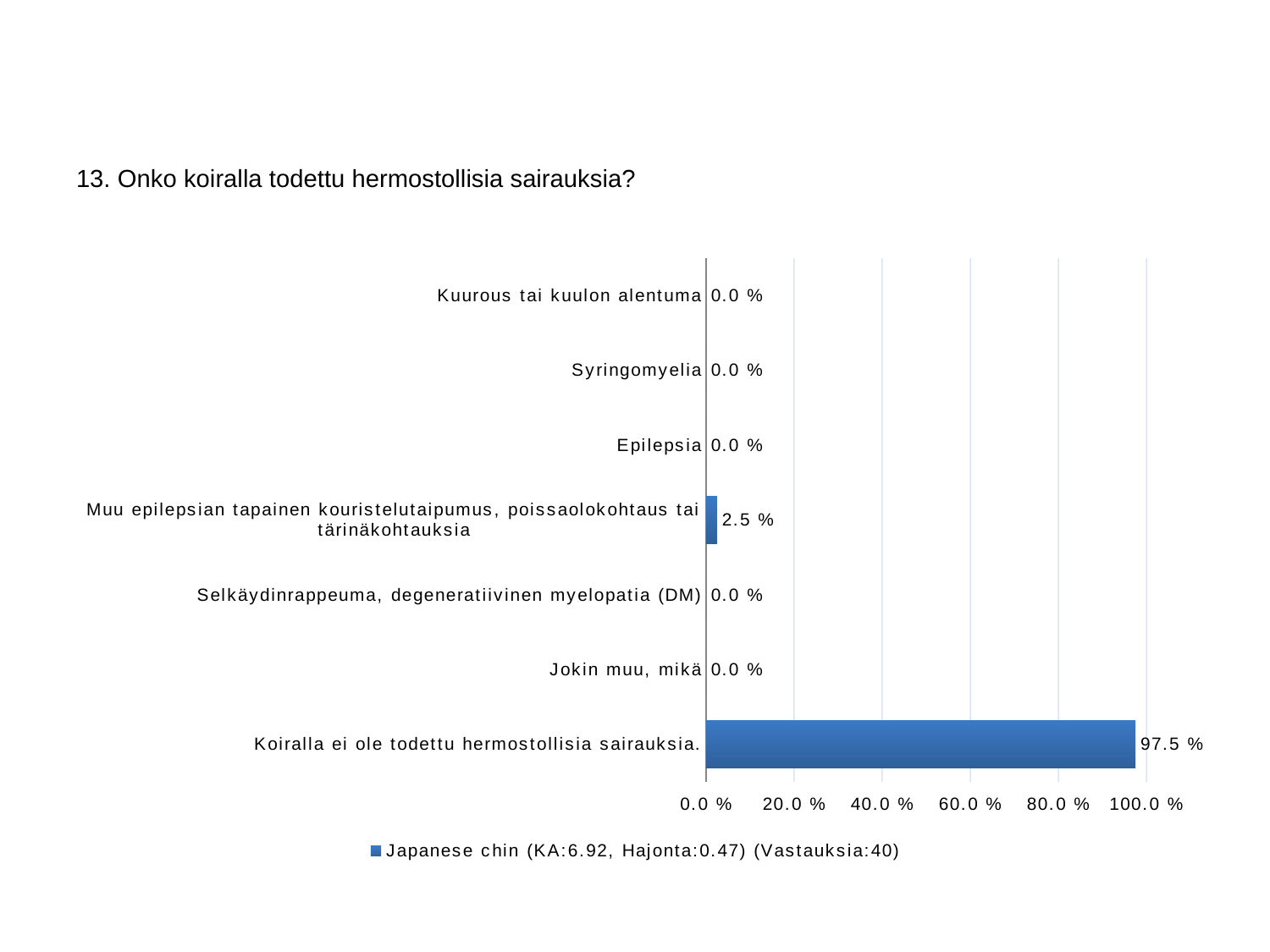
How many series does the legend list? 1 What is the difference between the values for "Koiralla ei ole todettu hermostollisia sairauksia." and "Muu epilepsian tapainen kouristelutaipumus, poissaolokohtaus tai tärinäkohtauksia"? 95.0 % Which is larger: the value for "Muu epilepsian tapainen kouristelutaipumus, poissaolokohtaus tai tärinäkohtauksia" or the value for "Kuurous tai kuulon alentuma"? Muu epilepsian tapainen kouristelutaipumus, poissaolokohtaus tai tärinäkohtauksia What kind of chart is shown on the slide? bar chart What is the value for "Muu epilepsian tapainen kouristelutaipumus, poissaolokohtaus tai tärinäkohtauksia"? 2.5 % Is the value for "Koiralla ei ole todettu hermostollisia sairauksia." greater or less than 80.0 %? greater What is the value for "Epilepsia"? 0.0 % What is the legend entry for the series shown in the chart? Japanese chin (KA:6.92, Hajonta:0.47) (Vastauksia:40) How many categories are shown in the chart? 7 What is the value for "Syringomyelia"? 0.0 % What is the value for "Koiralla ei ole todettu hermostollisia sairauksia."? 97.5 % Which category has the highest value? Koiralla ei ole todettu hermostollisia sairauksia.